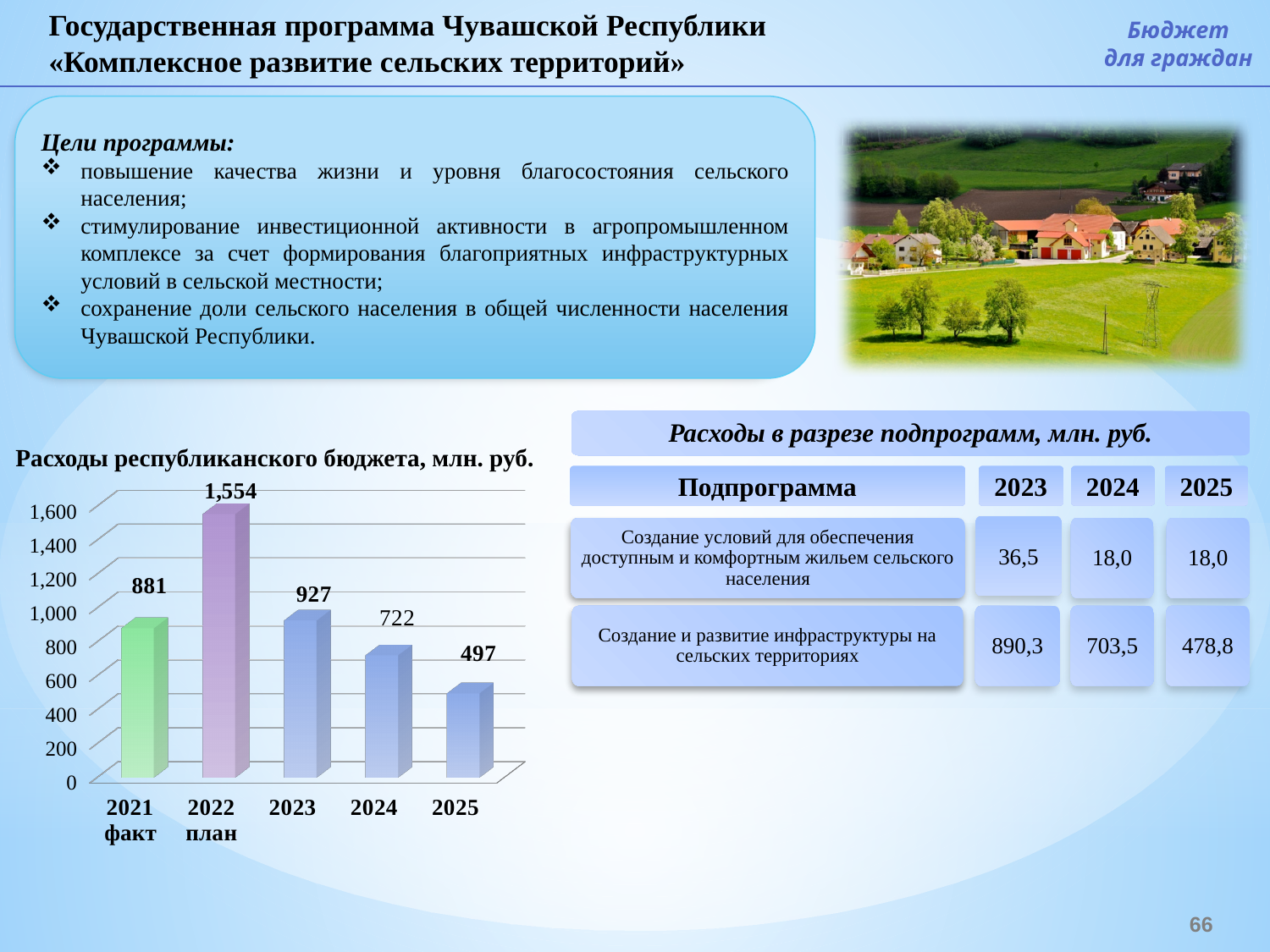
Is the value for 2024 greater or less than 800 in the chart 'Расходы республиканского бюджета, млн. руб.'? less Which category has the lowest value in the chart 'Расходы республиканского бюджета, млн. руб.'? 2025 What is the value for 2022 план in the chart 'Расходы республиканского бюджета, млн. руб.'? 1,554 What is the difference between the values for 2022 план and 2023 in the chart 'Расходы республиканского бюджета, млн. руб.'? 627 Which is larger in the chart 'Расходы республиканского бюджета, млн. руб.': the value for 2021 факт or the value for 2023? 2023 Do the values rise or fall from 2023 to 2025 in the chart 'Расходы республиканского бюджета, млн. руб.'? fall What is the value for 2025 in the chart 'Расходы республиканского бюджета, млн. руб.'? 497 How many categories are shown in the chart 'Расходы республиканского бюджета, млн. руб.'? 5 What is the value for 2021 факт in the chart 'Расходы республиканского бюджета, млн. руб.'? 881 What is the value for 2024 in the chart 'Расходы республиканского бюджета, млн. руб.'? 722 What kind of chart is 'Расходы республиканского бюджета, млн. руб.'? bar chart Which category has the highest value in the chart 'Расходы республиканского бюджета, млн. руб.'? 2022 план